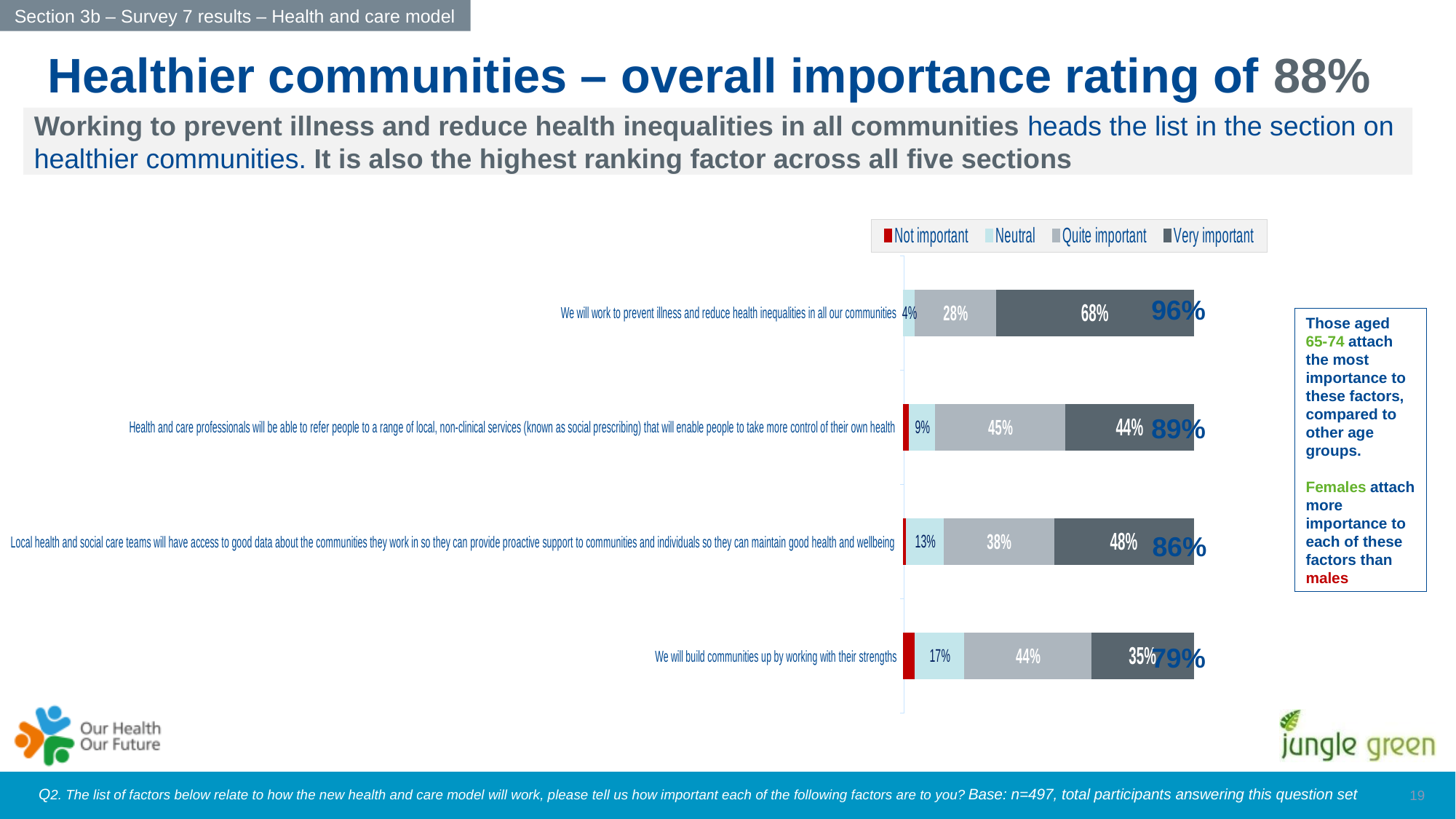
What is the 'Very important' value for 'We will work to prevent illness and reduce health inequalities in all our communities'? 68% What is the combined 'Quite important' plus 'Very important' total shown for the social prescribing factor? 89% Which factor has the highest 'Very important' value? We will work to prevent illness and reduce health inequalities in all our communities What is the 'Very important' value for the factor about local health and social care teams having access to good data about the communities they work in? 48% How many series does the chart legend list? 4 Which factor has the lowest combined importance rating (Quite important plus Very important) shown at the end of its bar? We will build communities up by working with their strengths What is the 'Neutral' value for 'We will build communities up by working with their strengths'? 17% Which is larger: the 'Neutral' value for the social prescribing factor or the 'Neutral' value for 'We will build communities up by working with their strengths'? We will build communities up by working with their strengths What kind of chart is shown on the slide? Stacked bar chart What is the difference between the 'Very important' values for 'We will work to prevent illness and reduce health inequalities in all our communities' (68%) and 'We will build communities up by working with their strengths' (35%)? 33% What is the 'Quite important' value for the social prescribing factor ('Health and care professionals will be able to refer people to a range of local, non-clinical services...')? 45% How many factors (categories) are plotted in the chart? 4